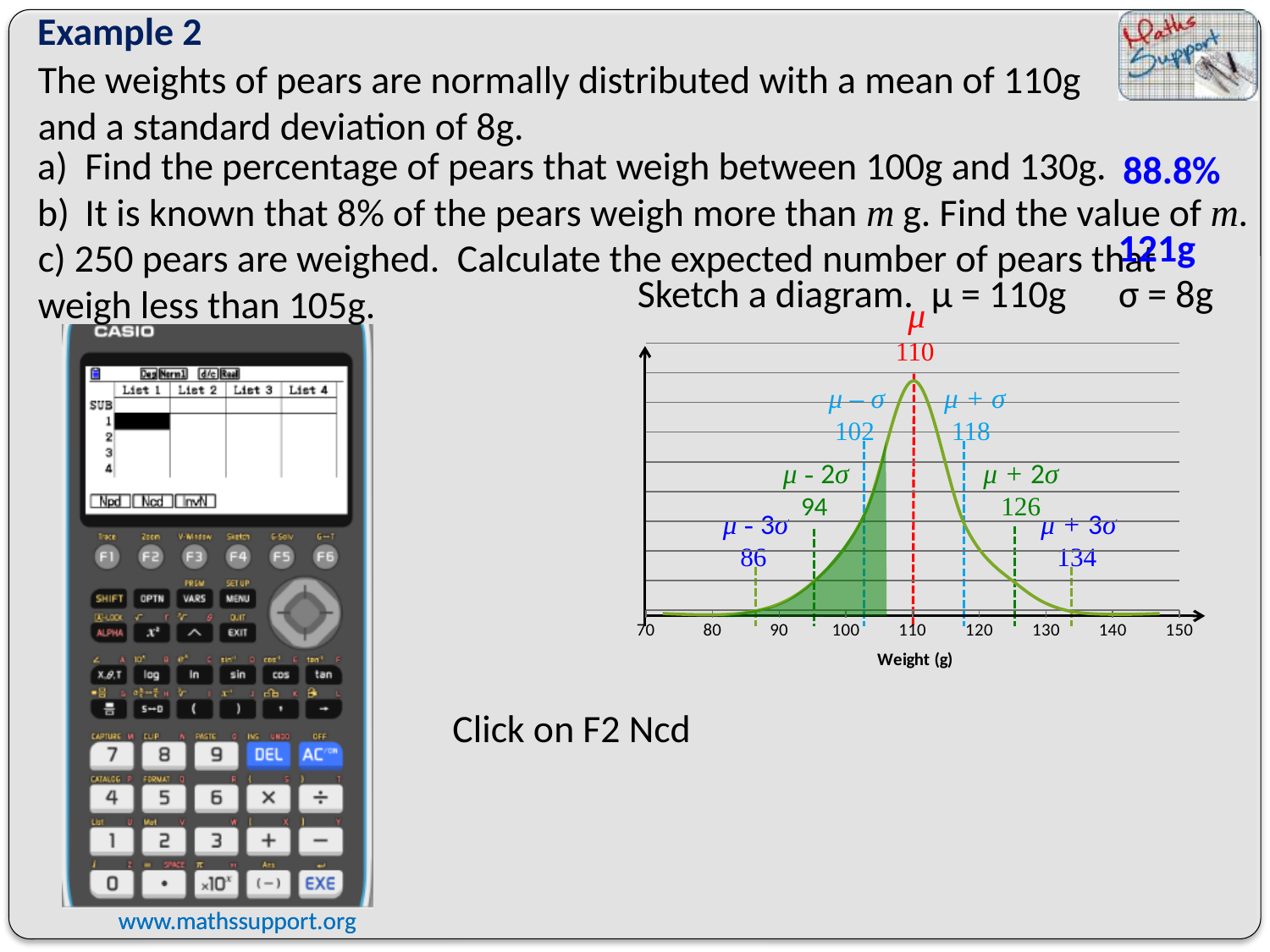
What weight value is labelled at μ + 3σ on the curve? 134 What weight value is labelled at μ − 3σ on the curve? 86 What weight value is labelled at the mean μ on the curve? 110 What weight value is labelled at μ − 2σ on the curve? 94 What kind of chart is the sketch on the right of the slide? line chart What weight value is labelled at μ + σ on the curve? 118 What is the lowest tick value shown on the x axis of the sketch? 70 How many labelled vertical dashed lines (μ and the σ positions) are drawn on the curve? 7 What weight value is labelled at μ − σ on the curve? 102 What is the highest tick value shown on the x axis of the sketch? 150 What is the difference between the values labelled at μ + σ and μ − σ? 16 What is the label on the x axis of the normal distribution sketch? Weight (g)